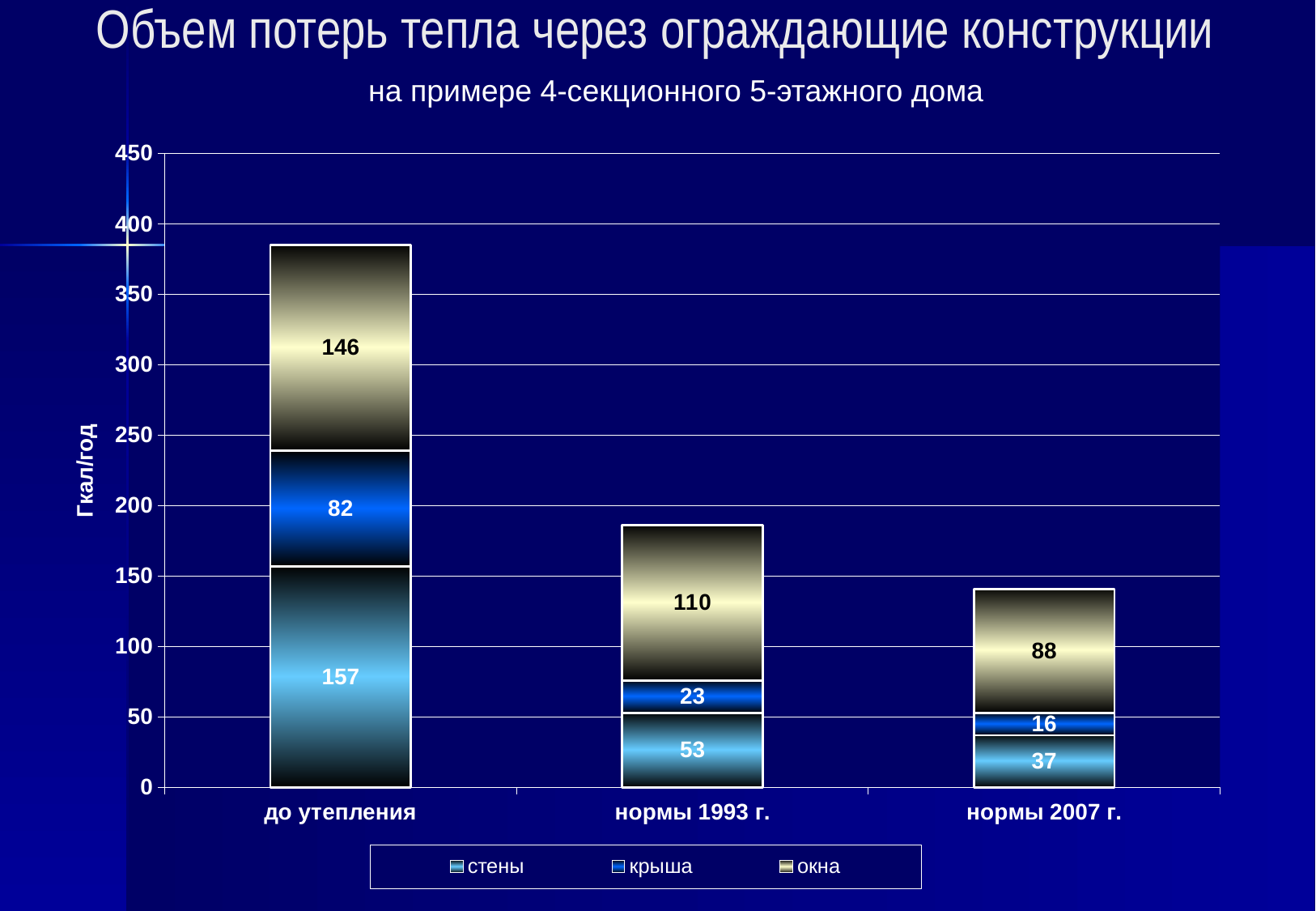
How many categories are shown on the x axis? 3 Which category has the lowest value for стены? нормы 2007 г. What type of chart is shown on the slide? stacked bar chart What is the value for стены in the до утепления bar? 157 What is the value for окна in the нормы 1993 г. bar? 110 What is the value for крыша in the нормы 2007 г. bar? 16 What is the total of the stacked bar for до утепления? 385 Which is larger: the окна value for нормы 2007 г. or the стены value for до утепления? стены value for до утепления What is the total of the stacked bar for нормы 2007 г.? 141 How many series does the legend list? 3 Which category has the highest value for окна? до утепления What is the difference between the крыша values for до утепления and нормы 1993 г.? 59